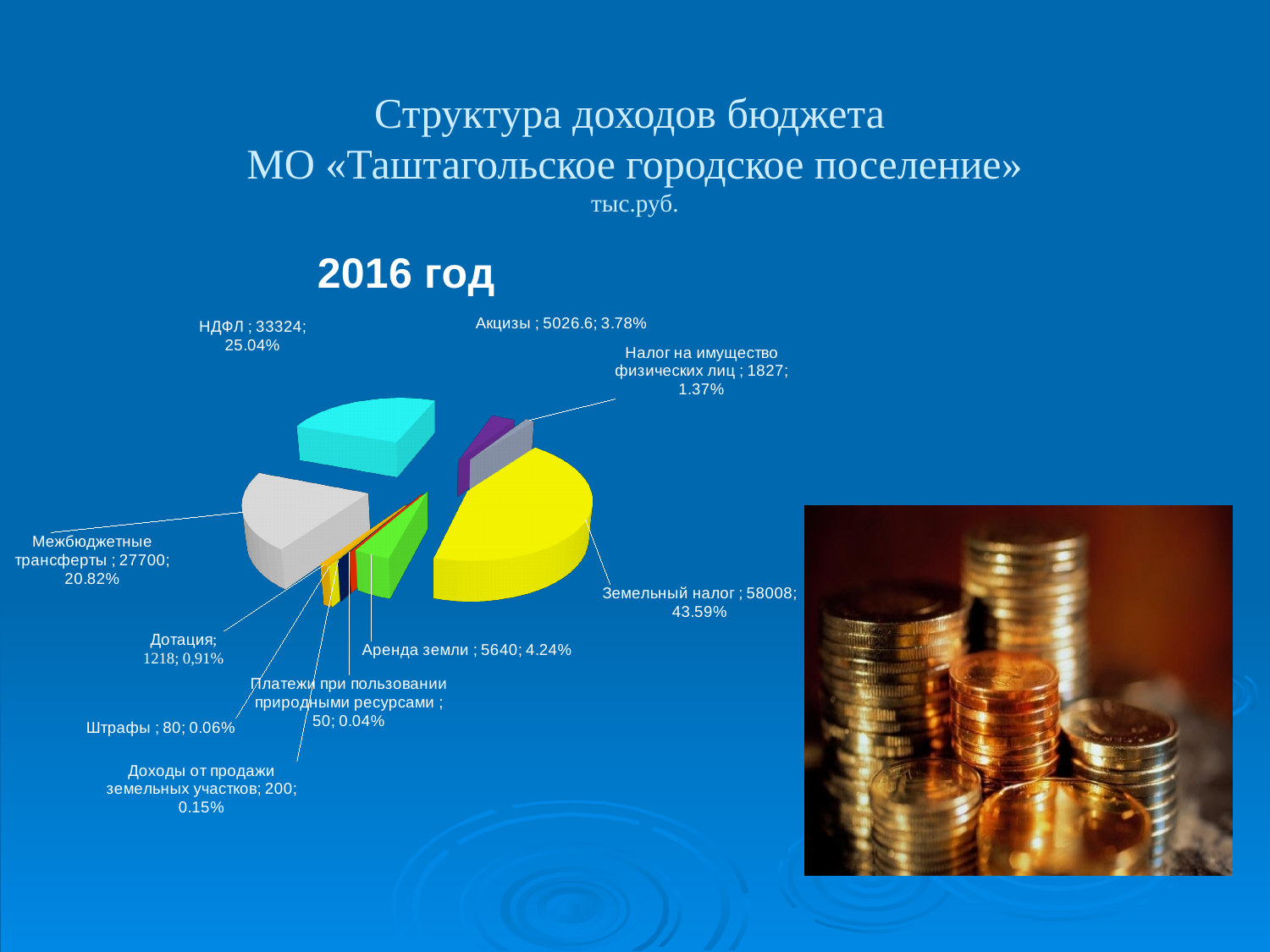
What kind of chart is shown on the slide? pie chart What year does the chart title refer to? 2016 год Which is larger, the value for Аренда земли or the value for Акцизы? Аренда земли Which category has the smallest share of the pie? Платежи при пользовании природными ресурсами What is the difference between the values for Земельный налог and НДФЛ? 24684 What share of the pie does Налог на имущество физических лиц represent? 1.37% Which category has the largest share of the pie? Земельный налог What share of the pie does НДФЛ represent? 25.04% What is the value for Земельный налог? 58008 What is the value for Межбюджетные трансферты? 27700 How many categories are shown in the pie chart? 10 What is the value for Акцизы? 5026.6